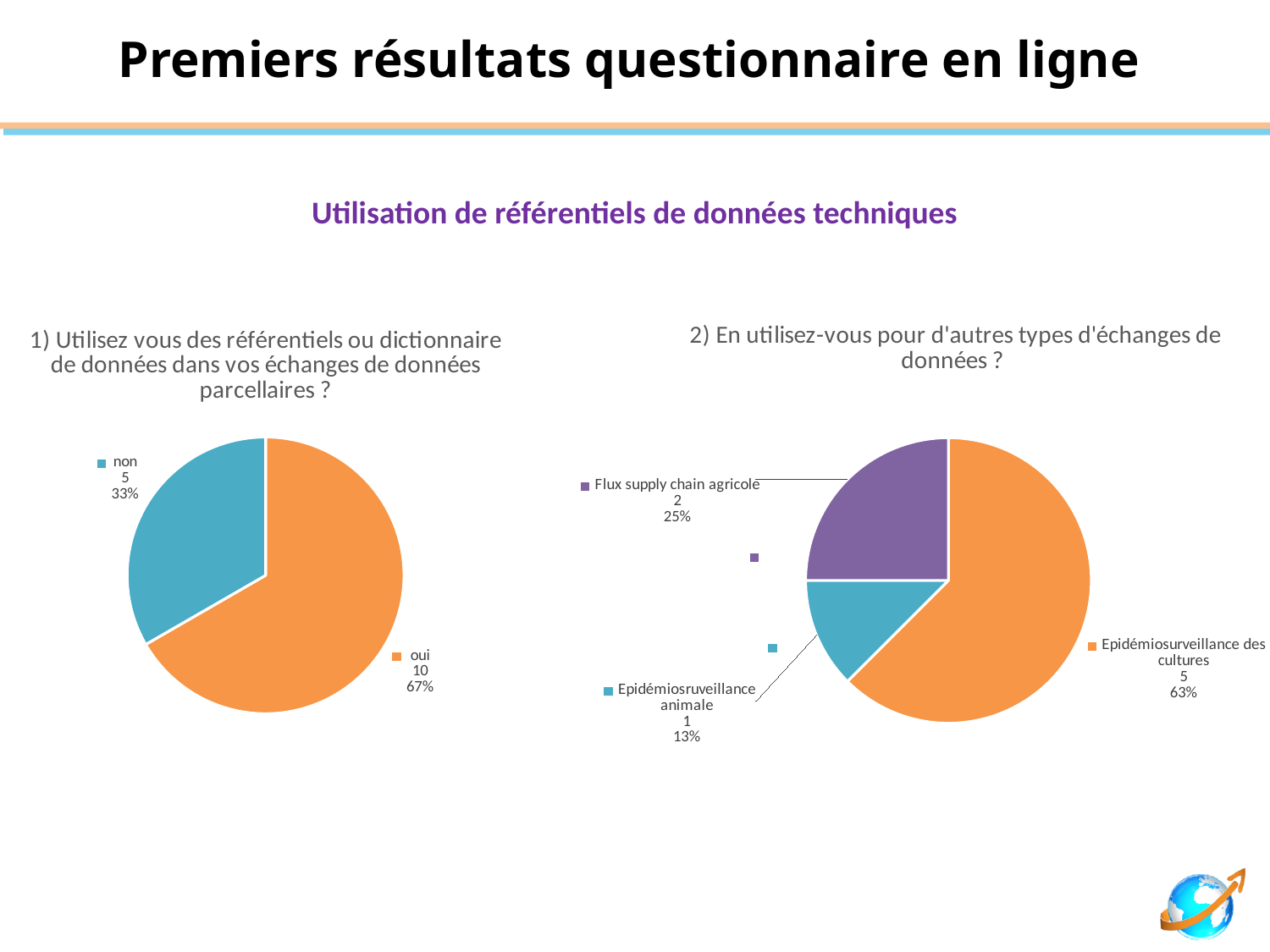
In the right chart (question 2 about other types of data exchanges), how many categories are shown? 3 In the right chart (question 2 about other types of data exchanges), which category has the smallest share? Epidémiosruveillance animale In the left chart (question 1 about données parcellaires), what is the difference between the number of "oui" and "non" answers? 5 In the left chart (question 1 about données parcellaires), what percentage of respondents answered "non"? 33% In the right chart (question 2 about other types of data exchanges), which is larger: "Flux supply chain agricole" or "Epidémiosruveillance animale"? Flux supply chain agricole In the right chart (question 2 about other types of data exchanges), what percentage does "Flux supply chain agricole" represent? 25% In the left chart (question 1 about données parcellaires), what type of chart is shown? pie chart In the right chart (question 2 about other types of data exchanges), how many respondents chose "Epidémiosurveillance des cultures"? 5 In the left chart (question 1 about données parcellaires), how many respondents answered "oui"? 10 In the right chart (question 2 about other types of data exchanges), which category has the largest share? Epidémiosurveillance des cultures In the left chart (question 1 about données parcellaires), how many slices does the pie have? 2 In the right chart (question 2 about other types of data exchanges), what colour is the "Epidémiosurveillance des cultures" slice? orange